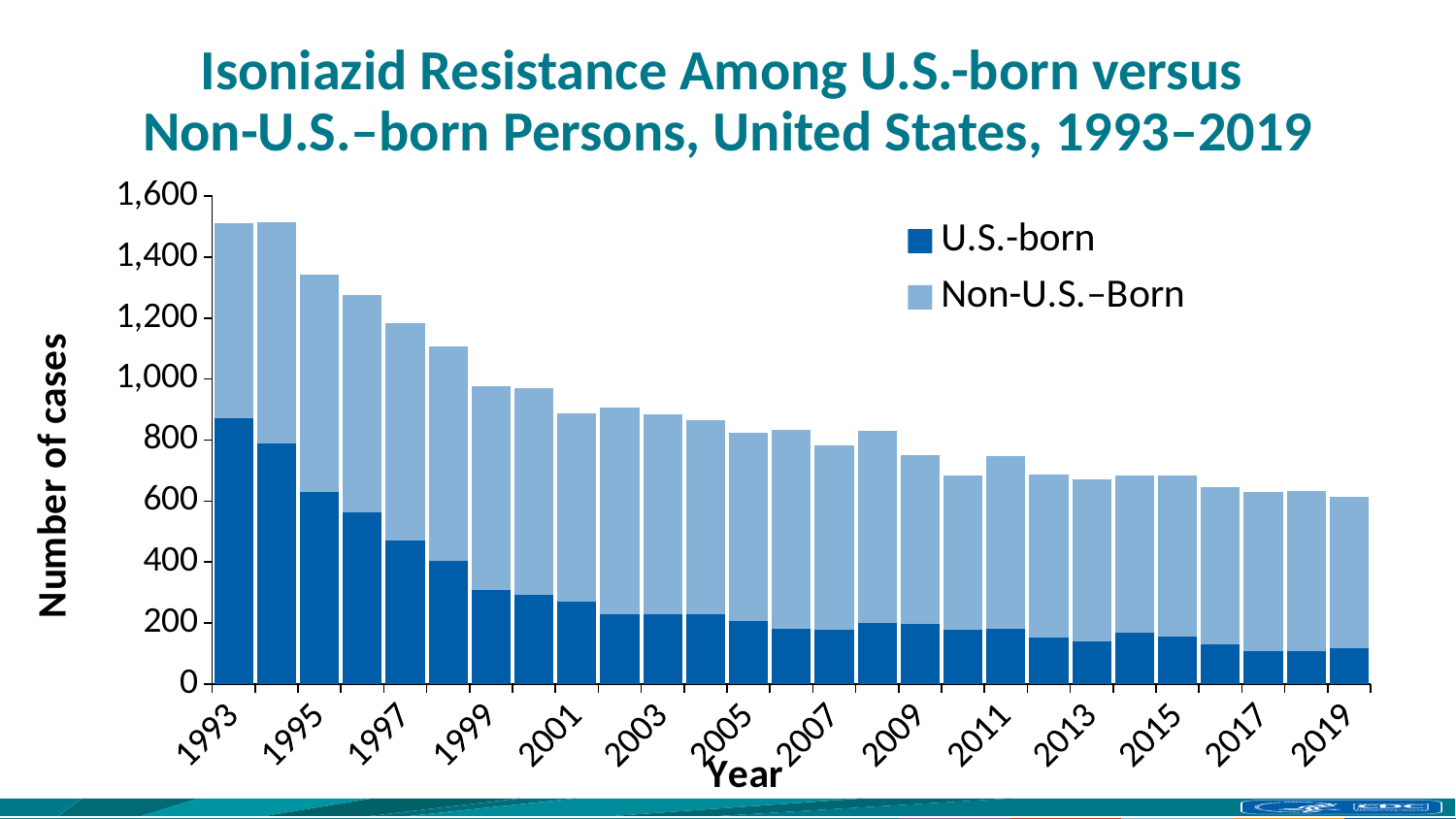
Which is larger, the total number of cases in 1995 or in 2005? 1995 Does the number of U.S.-born cases generally rise or fall from 1993 to 2019? Fall How many series does the legend list? 2 What are the two series named in the legend? U.S.-born and Non-U.S.–Born What is the label on the y axis? Number of cases Is the total number of cases in 1993 greater or less than 1,400? greater Is the number of U.S.-born cases in 1993 greater or less than 800? greater Which year has the highest number of U.S.-born cases? 1993 Is the number of U.S.-born cases in 2019 greater or less than 200? less What kind of chart is shown on the slide? Stacked bar chart How many years (bars) are plotted in the chart? 27